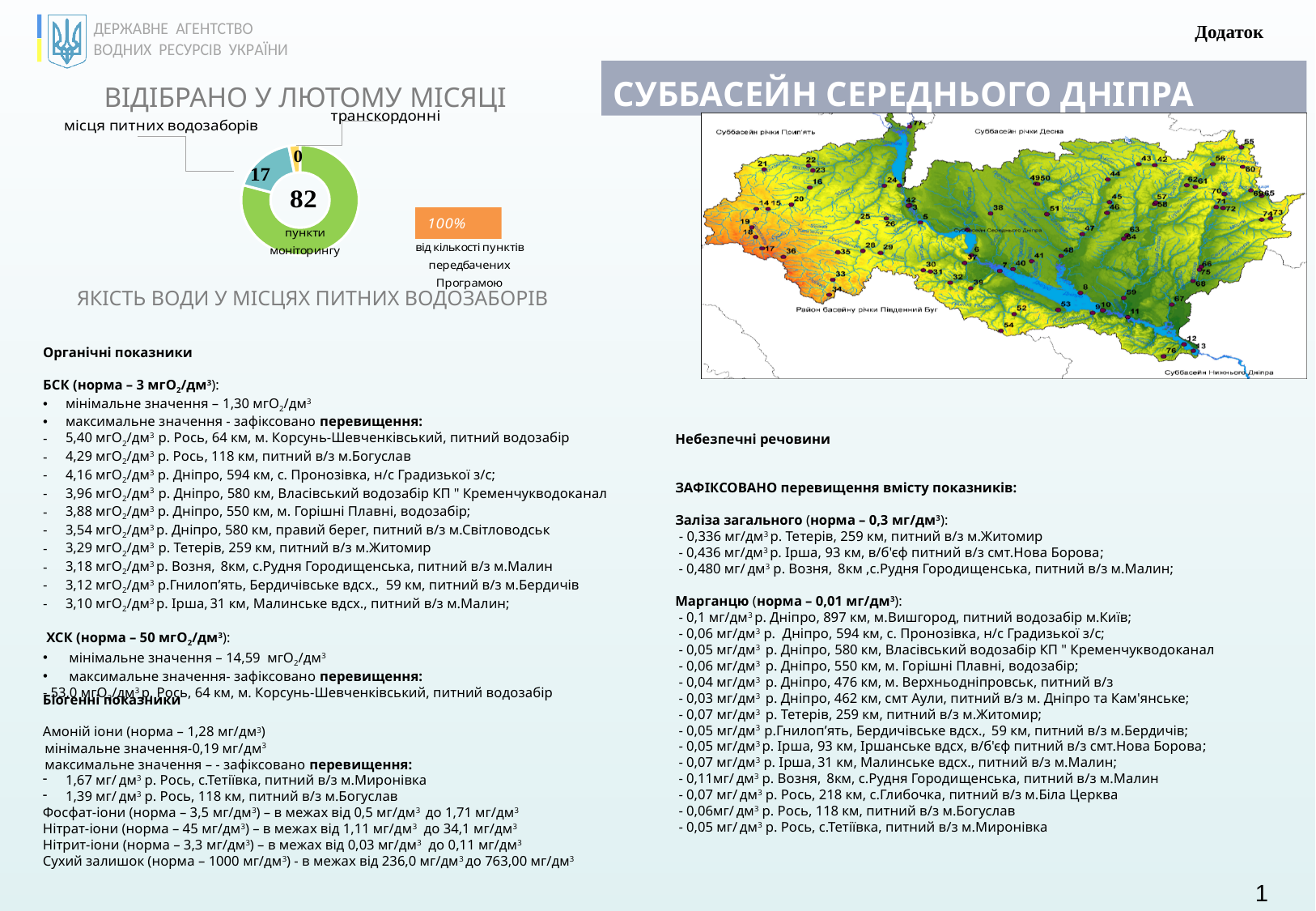
What kind of chart is shown under the title "ВІДІБРАНО У ЛЮТОМУ МІСЯЦІ"? Doughnut (pie) chart How many categories are shown in the doughnut chart? 3 Which category in the doughnut chart has the smallest value? транскордонні What is the title of the doughnut chart on the slide? ВІДІБРАНО У ЛЮТОМУ МІСЯЦІ In the doughnut chart, what value is shown for "транскордонні"? 0 In the doughnut chart, what value is shown for "місця питних водозаборів"? 17 In the doughnut chart, what value is shown for "пункти моніторингу"? 82 In the doughnut chart, which is larger: "місця питних водозаборів" or "транскордонні"? місця питних водозаборів What colour is the segment for "пункти моніторингу" in the doughnut chart? Green Which category in the doughnut chart has the largest value? пункти моніторингу In the doughnut chart, what is the difference between the value for "пункти моніторингу" and the value for "місця питних водозаборів"? 65 What percentage is shown in the orange box next to the doughnut chart? 100%